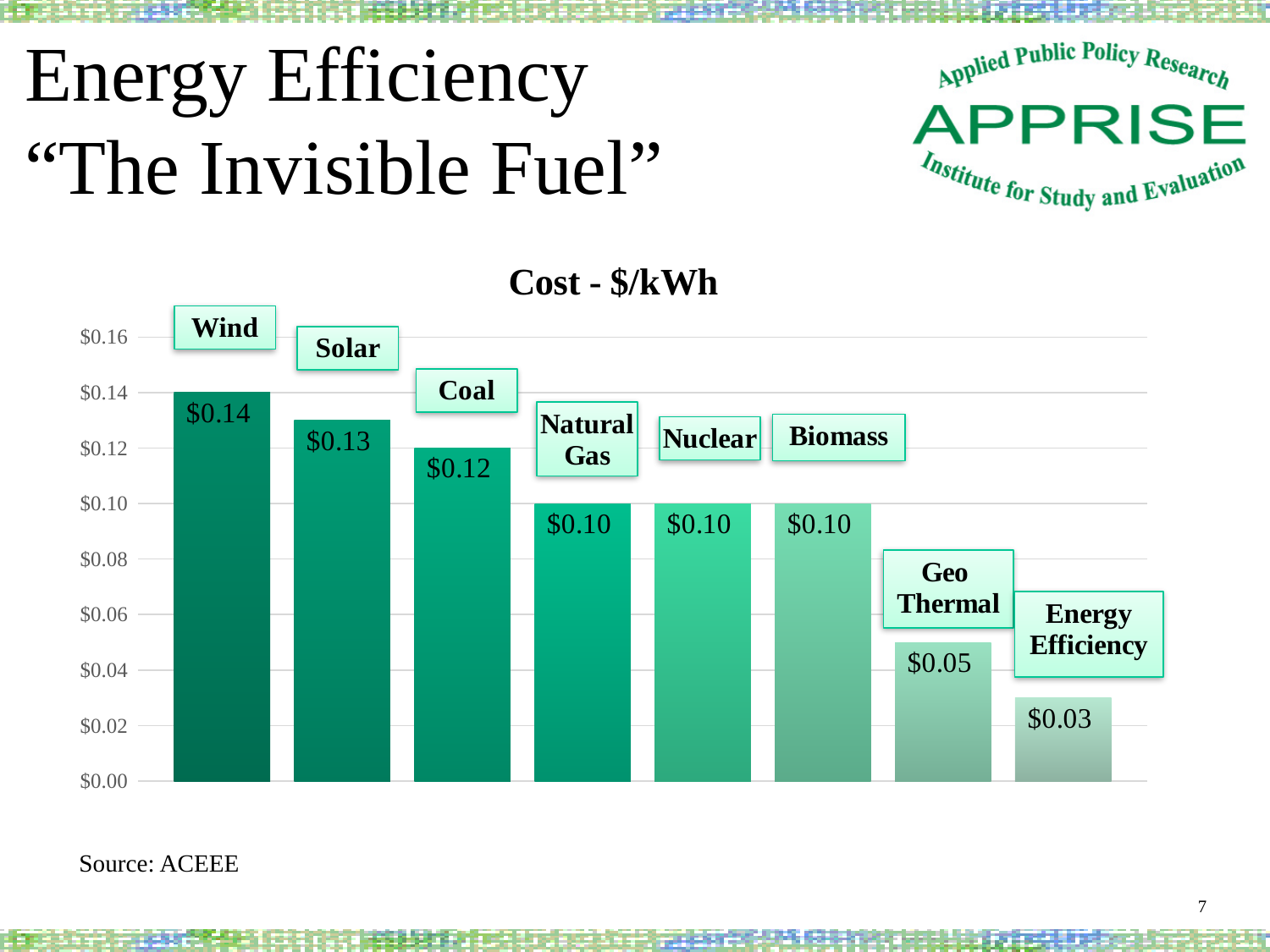
What type of chart is shown on the slide? Bar chart What is the cost in $/kWh for Coal? $0.12 Which energy source has the lowest cost per kWh? Energy Efficiency What is the title of the chart? Cost - $/kWh What is the cost in $/kWh for Wind? $0.14 Which energy source has the highest cost per kWh? Wind What is the difference in cost per kWh between Wind and Energy Efficiency? $0.11 Which has a higher cost per kWh, Solar or Natural Gas? Solar What is the difference in cost per kWh between Solar and Geo Thermal? $0.08 How many energy sources are shown in the chart? 8 What is the cost in $/kWh for Energy Efficiency? $0.03 What is the cost in $/kWh for Geo Thermal? $0.05